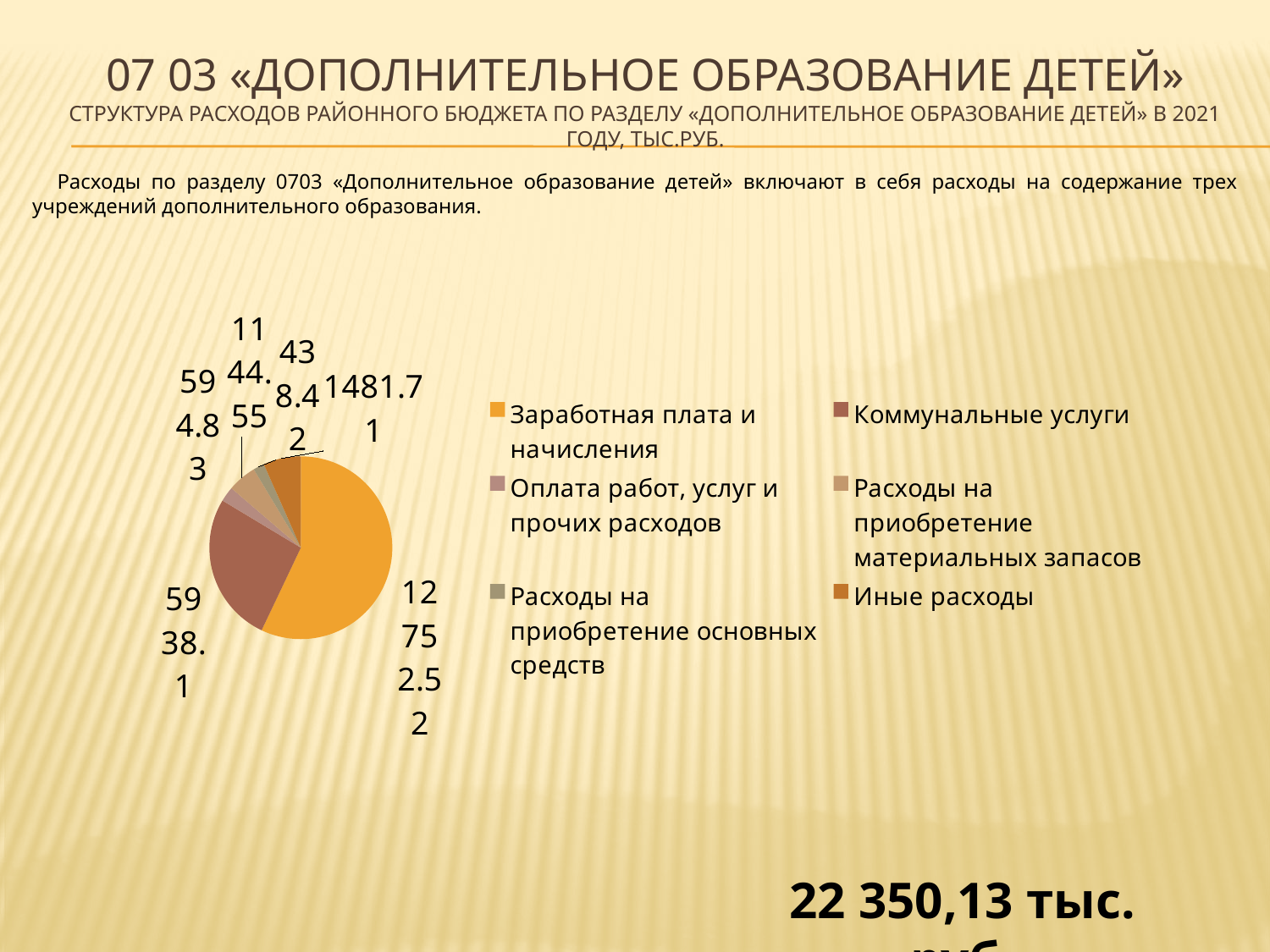
What is the value for «Заработная плата и начисления»? 12752.52 How many entries does the legend list? 6 How many slices does the pie chart have? 6 What is the value for «Расходы на приобретение основных средств»? 438.42 What kind of chart is shown on the slide? Pie chart Which category has the largest slice of the pie? Заработная плата и начисления Which category has the smallest slice of the pie? Расходы на приобретение основных средств What is the value for «Иные расходы»? 1481.71 What is the difference between «Заработная плата и начисления» and «Коммунальные услуги»? 6814.42 What is the value for «Расходы на приобретение материальных запасов»? 1144.55 What is the value for «Коммунальные услуги»? 5938.1 Which is larger: «Коммунальные услуги» or «Иные расходы»? Коммунальные услуги